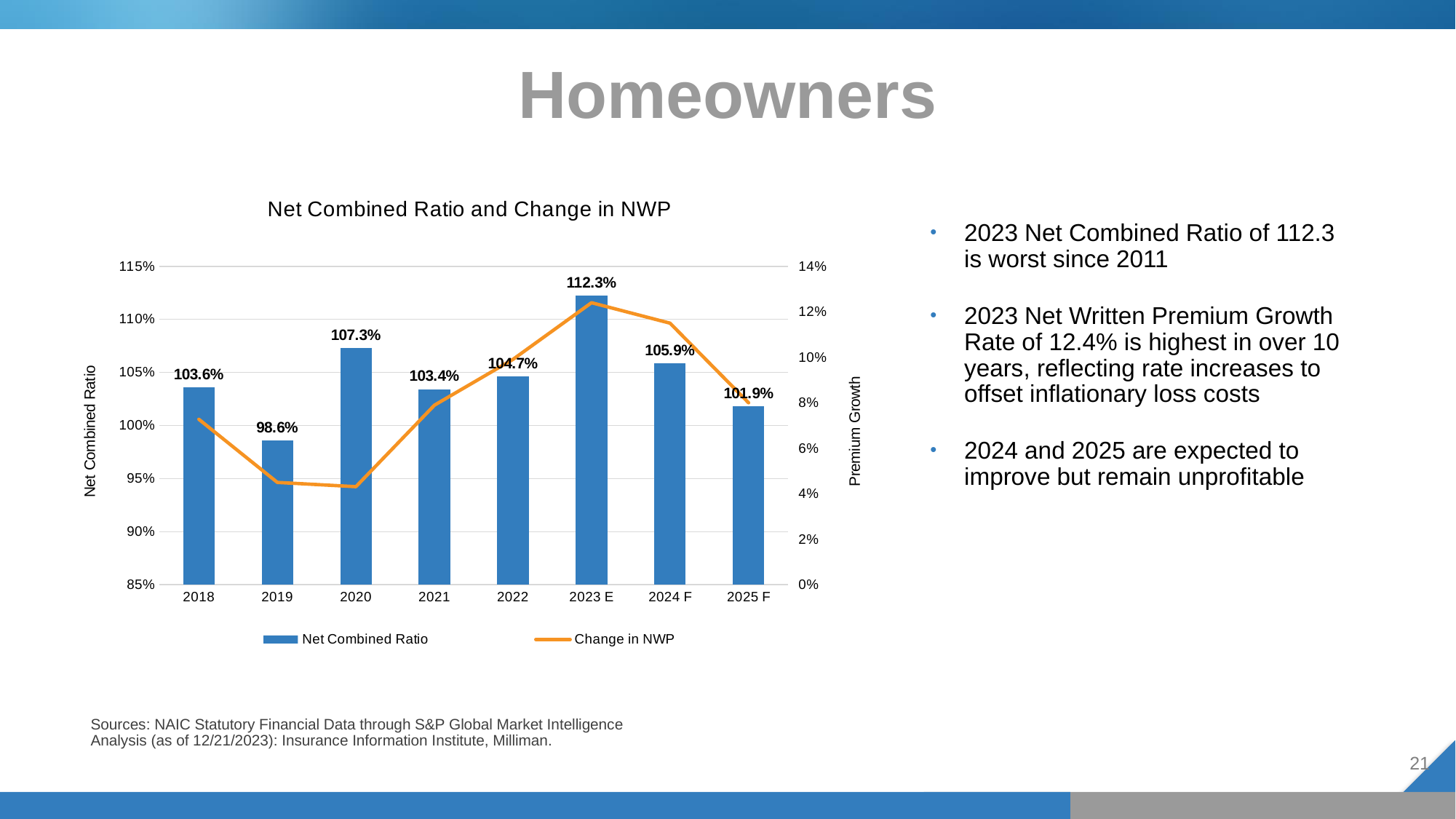
What is the Net Combined Ratio for 2019? 98.6% Which year has the highest Net Combined Ratio? 2023 E Which is larger, the Net Combined Ratio for 2020 or for 2024 F? 2020 Is the Change in NWP value for 2020 greater or less than 6%? less Which year has the lowest Net Combined Ratio? 2019 How many series does the chart legend list? 2 Is the Change in NWP value for 2024 F greater or less than 10%? greater What is the Net Combined Ratio for 2023 E? 112.3% What is the Net Combined Ratio for 2025 F? 101.9% What is the title of the chart? Net Combined Ratio and Change in NWP How many years are shown on the x axis of the chart? 8 What is the difference between the Net Combined Ratio for 2023 E and for 2019? 13.7 percentage points